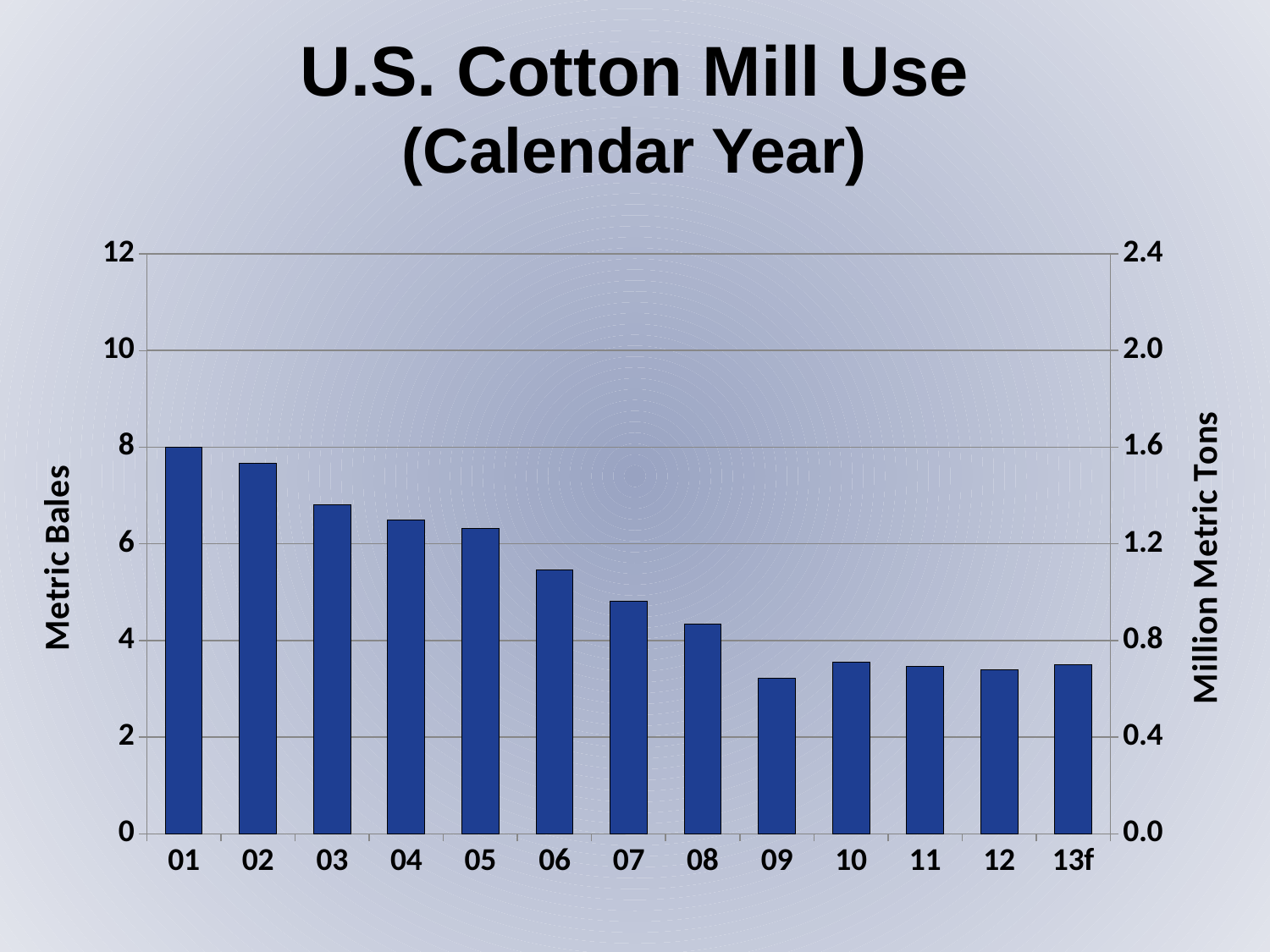
How many years (categories) are plotted on the x axis? 13 What is the title of the left vertical axis? Metric Bales Is the value for 07 greater or less than 4 on the Metric Bales axis? greater Which year has the highest U.S. cotton mill use? 01 Is the value for 02 greater or less than 6 on the Metric Bales axis? greater Do the values generally rise or fall from 01 to 13f? fall Which is larger, the value for 03 or the value for 08? 03 What is the title of the right vertical axis? Million Metric Tons What kind of chart is shown on the slide? bar chart Is the value for 06 greater or less than 6 on the Metric Bales axis? less